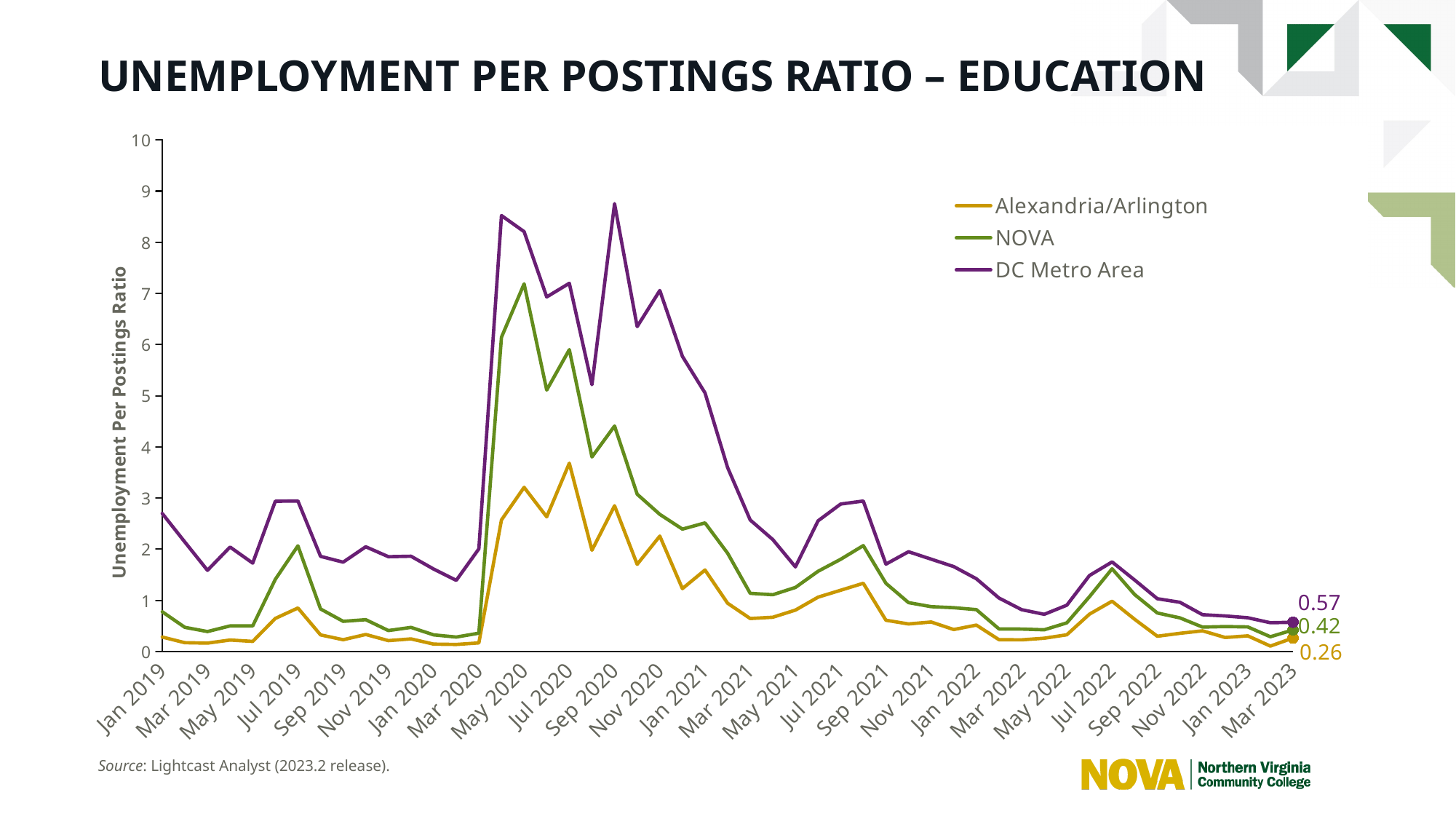
How many series does the legend list? 3 What kind of chart is shown on the slide? Line chart Which series has the lowest value in Mar 2023? Alexandria/Arlington What is the value for Alexandria/Arlington in Mar 2023? 0.26 Is the value for DC Metro Area in Jan 2019 greater or less than 2? greater What is the difference between the DC Metro Area and Alexandria/Arlington values in Mar 2023? 0.31 In Mar 2023, which is larger: the NOVA value or the Alexandria/Arlington value? NOVA Is the value for NOVA in Jan 2019 greater or less than 1? less What is the difference between the NOVA and Alexandria/Arlington values in Mar 2023? 0.16 Which series has the highest value in Mar 2023? DC Metro Area What is the value for NOVA in Mar 2023? 0.42 What is the value for DC Metro Area in Mar 2023? 0.57